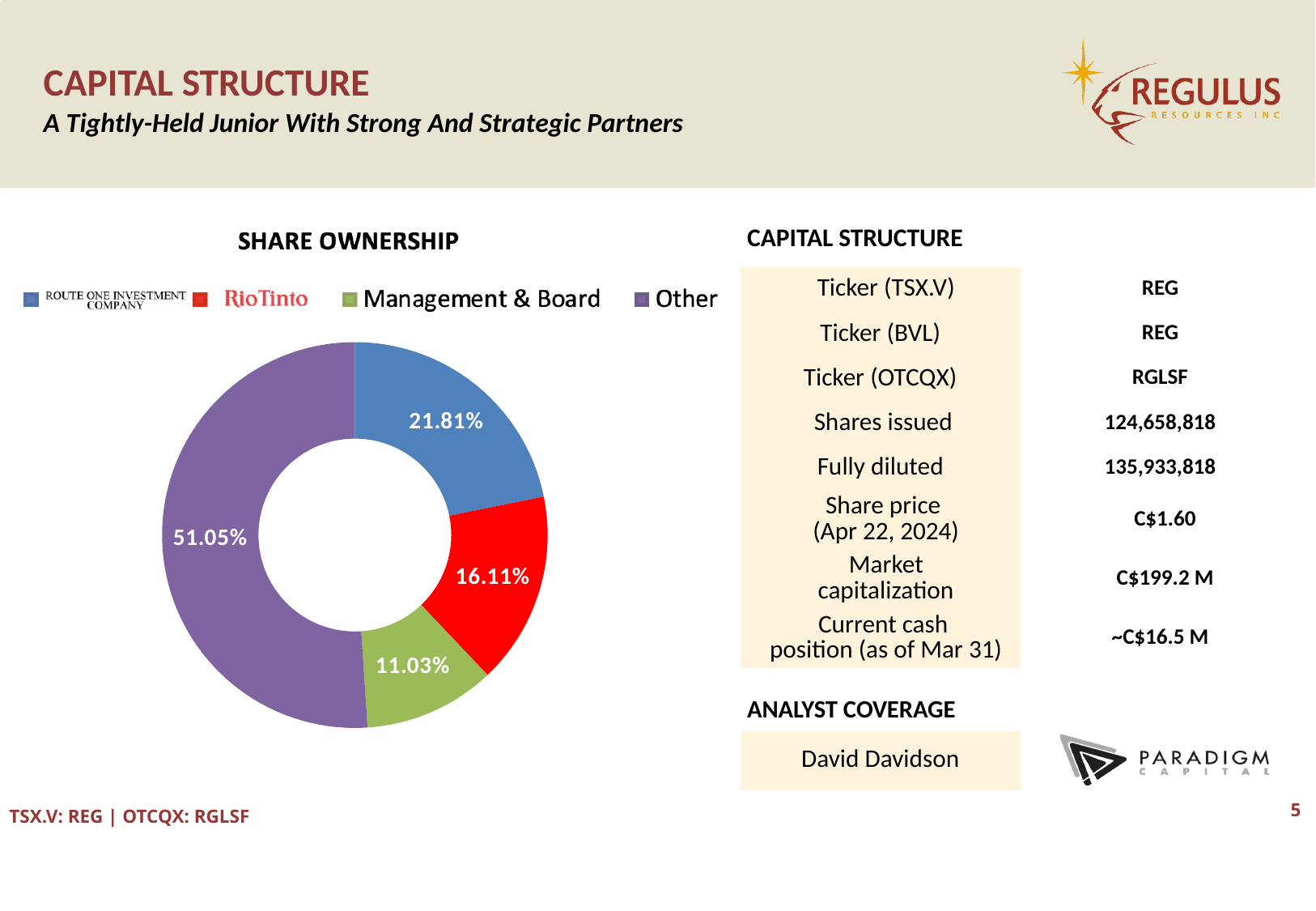
Which category has the largest slice in the Share Ownership chart? Other What share of the Share Ownership chart is held by Route One Investment Company? 21.81% What share of the Share Ownership chart is held by Other? 51.05% What share of the Share Ownership chart is held by Rio Tinto? 16.11% In the Share Ownership chart, which is larger: the Rio Tinto share or the Management & Board share? Rio Tinto In the Share Ownership chart, what is the difference between the Route One Investment Company share and the Rio Tinto share? 5.70% How many slices does the Share Ownership chart have? 4 What colour is the Other slice in the Share Ownership chart? Purple What share of the Share Ownership chart is held by Management & Board? 11.03% Which category has the smallest slice in the Share Ownership chart? Management & Board What kind of chart is the Share Ownership chart? Pie chart (donut) What is the title of the chart on the slide? SHARE OWNERSHIP